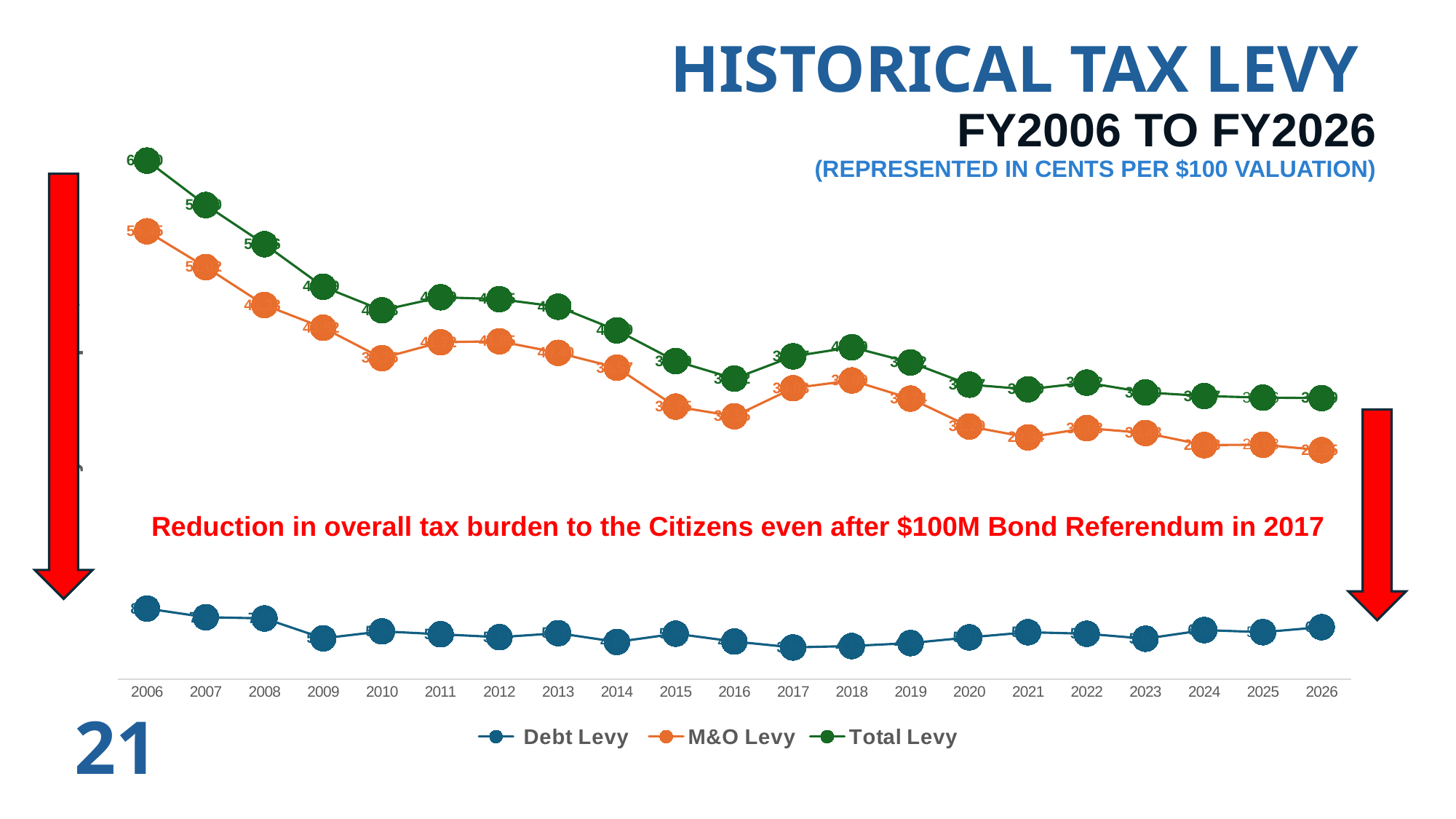
Which is larger in 2006, the Total Levy or the Debt Levy? Total Levy Which series does the legend list first? Debt Levy Which series is plotted lowest on the chart across all years? Debt Levy What kind of chart is shown on the slide? Line chart In which year is the M&O Levy highest? 2006 Does the M&O Levy generally rise or fall from 2006 to 2026? Fall Which is larger for the M&O Levy, the 2006 value or the 2026 value? 2006 How many series does the legend list? 3 In which year is the Total Levy highest? 2006 Does the Total Levy generally rise or fall from 2006 to 2026? Fall What is the title of the chart? HISTORICAL TAX LEVY FY2006 TO FY2026 How many years are plotted along the x axis? 21